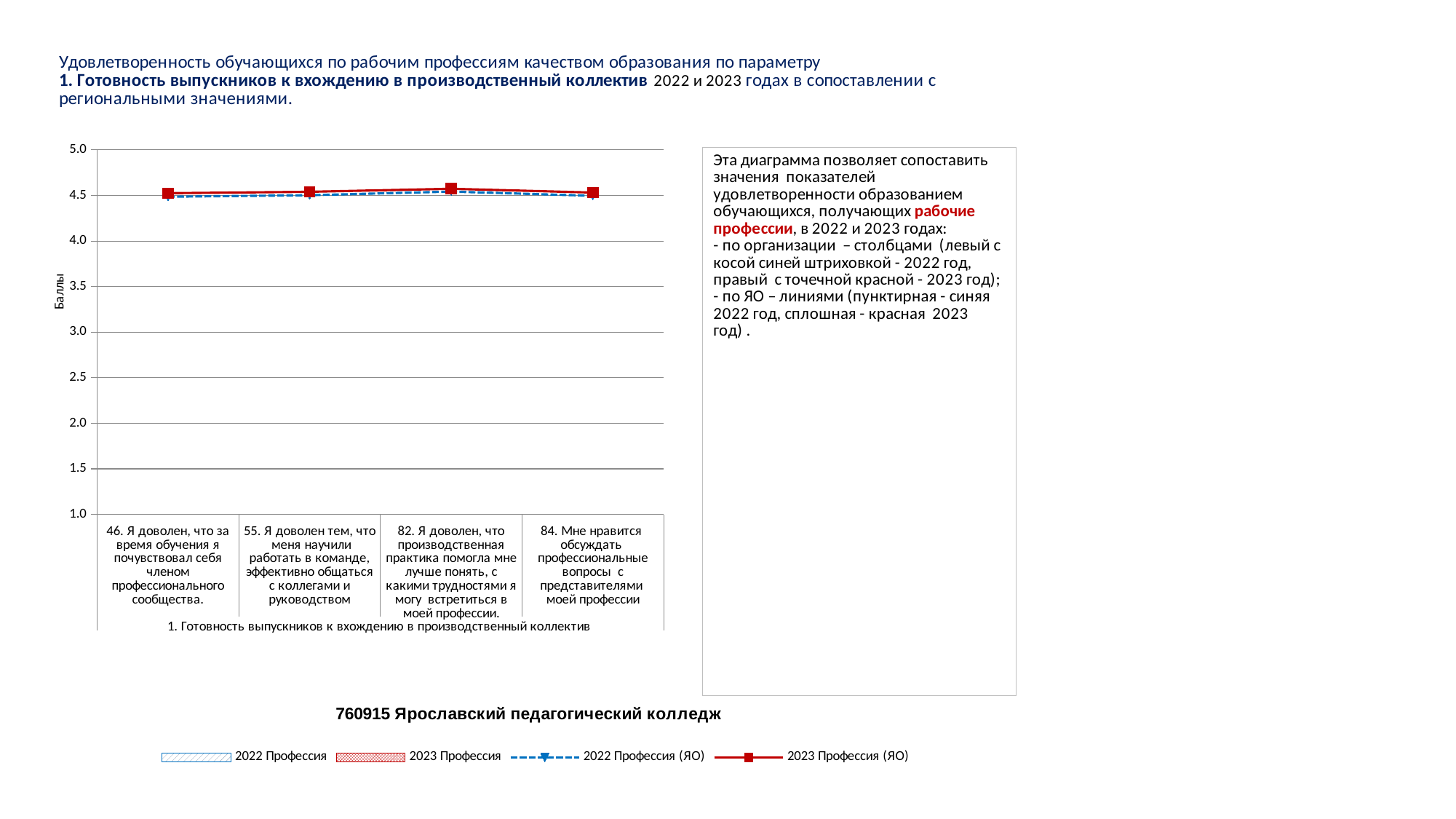
Is the value of the 2022 Профессия (ЯО) line for category 46 greater or less than 5.0? less What is the label of the vertical axis of the chart? Баллы What is the lowest value shown on the vertical axis of the chart? 1.0 What is the highest value shown on the vertical axis of the chart? 5.0 What kind of chart is plotted on the slide (the visible data)? line chart Is the value of the 2023 Профессия (ЯО) line for category 82 greater or less than 4.0? greater Is the value of the 2023 Профессия (ЯО) line for category 84 greater or less than 4.0? greater For category 82, which line is higher: 2022 Профессия (ЯО) or 2023 Профессия (ЯО)? 2023 Профессия (ЯО) What title is printed below the chart? 760915 Ярославский педагогический колледж For which category does the 2023 Профессия (ЯО) line reach its highest value? 82. Я доволен, что производственная практика помогла мне лучше понять, с какими трудностями я могу встретиться в моей профессии. How many series does the chart legend list? 4 How many categories (questions) are shown along the x axis of the chart? 4